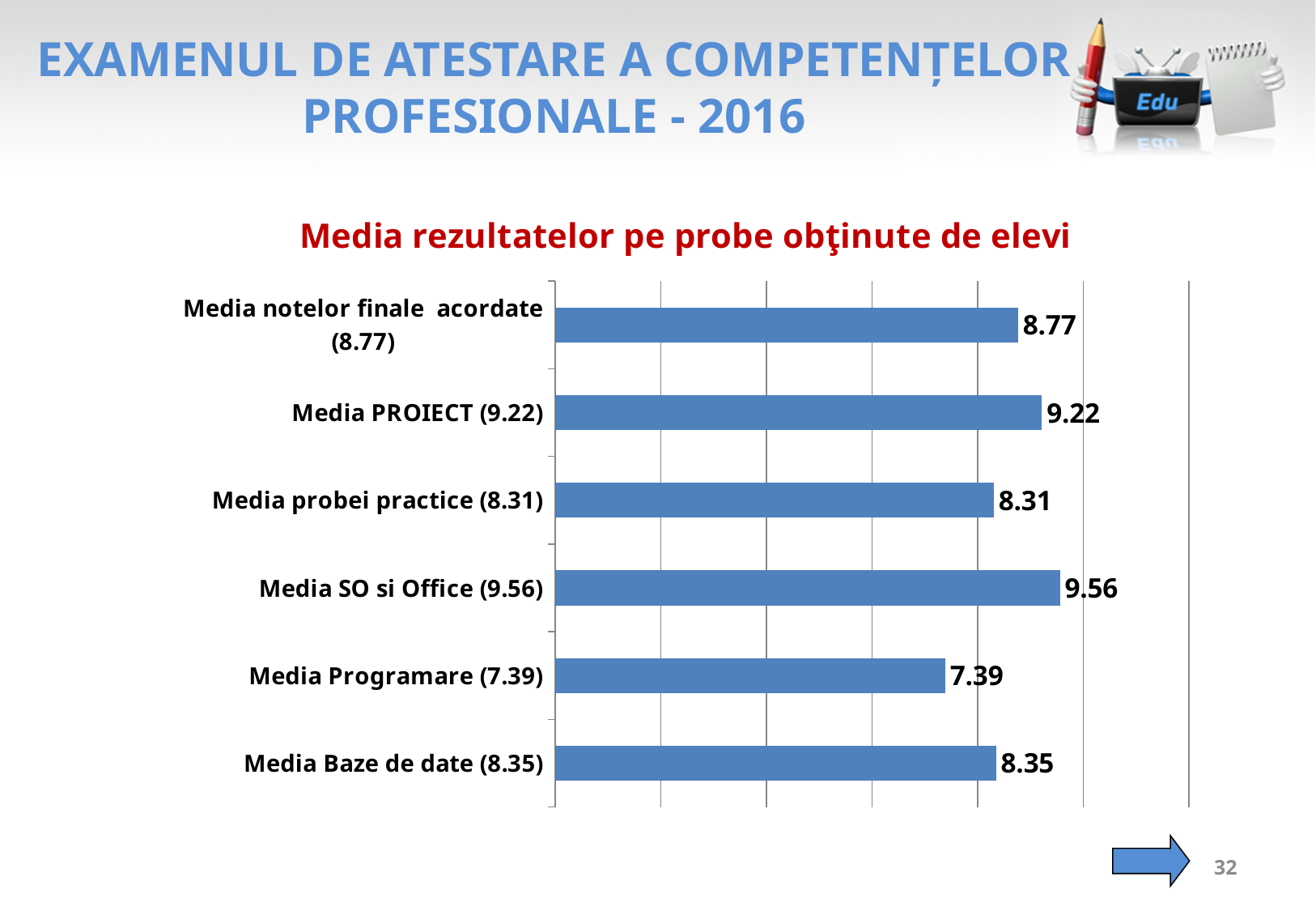
What is the difference between Media PROIECT and Media probei practice? 0.91 How many categories are shown in the chart? 6 What is the difference between Media SO si Office and Media Programare? 2.17 Which is larger, Media notelor finale acordate or Media probei practice? Media notelor finale acordate Which category has the highest value? Media SO si Office What is the value for Media Programare? 7.39 Which is larger, Media Baze de date or Media Programare? Media Baze de date Which category has the lowest value? Media Programare What kind of chart is shown on the slide? Bar chart What is the title of the chart? Media rezultatelor pe probe obţinute de elevi What is the value for Media PROIECT? 9.22 What is the value for Media Baze de date? 8.35